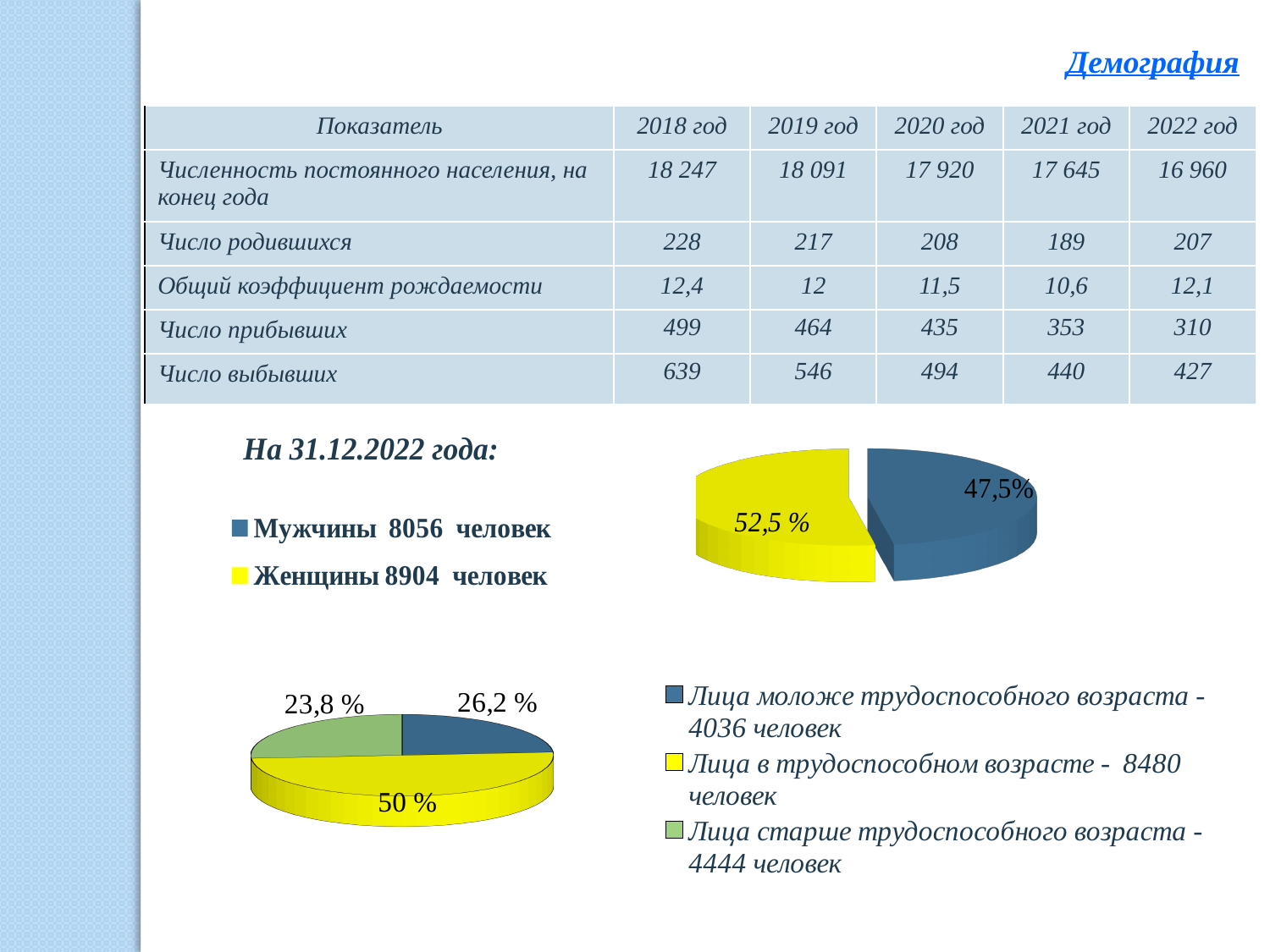
In the upper pie chart, what share of the population is shown for Мужчины? 47,5% In the upper pie chart, which group is larger, Мужчины or Женщины? Женщины In the upper pie chart, how many slices are there? 2 In the lower pie chart, how many people does the legend give for Лица моложе трудоспособного возраста? 4036 человек In the lower pie chart, what share is shown for Лица старше трудоспособного возраста? 23,8 % In the lower pie chart, what share is shown for Лица в трудоспособном возрасте? 50 % In the upper pie chart, how many people does the legend give for Мужчины? 8056 человек In the lower pie chart, which category has the smallest slice? Лица старше трудоспособного возраста In the lower pie chart, which category has the largest slice? Лица в трудоспособном возрасте In the lower pie chart, what colour is the slice for Лица старше трудоспособного возраста? green What kind of chart is the upper chart on the slide (next to 'На 31.12.2022 года')? pie chart